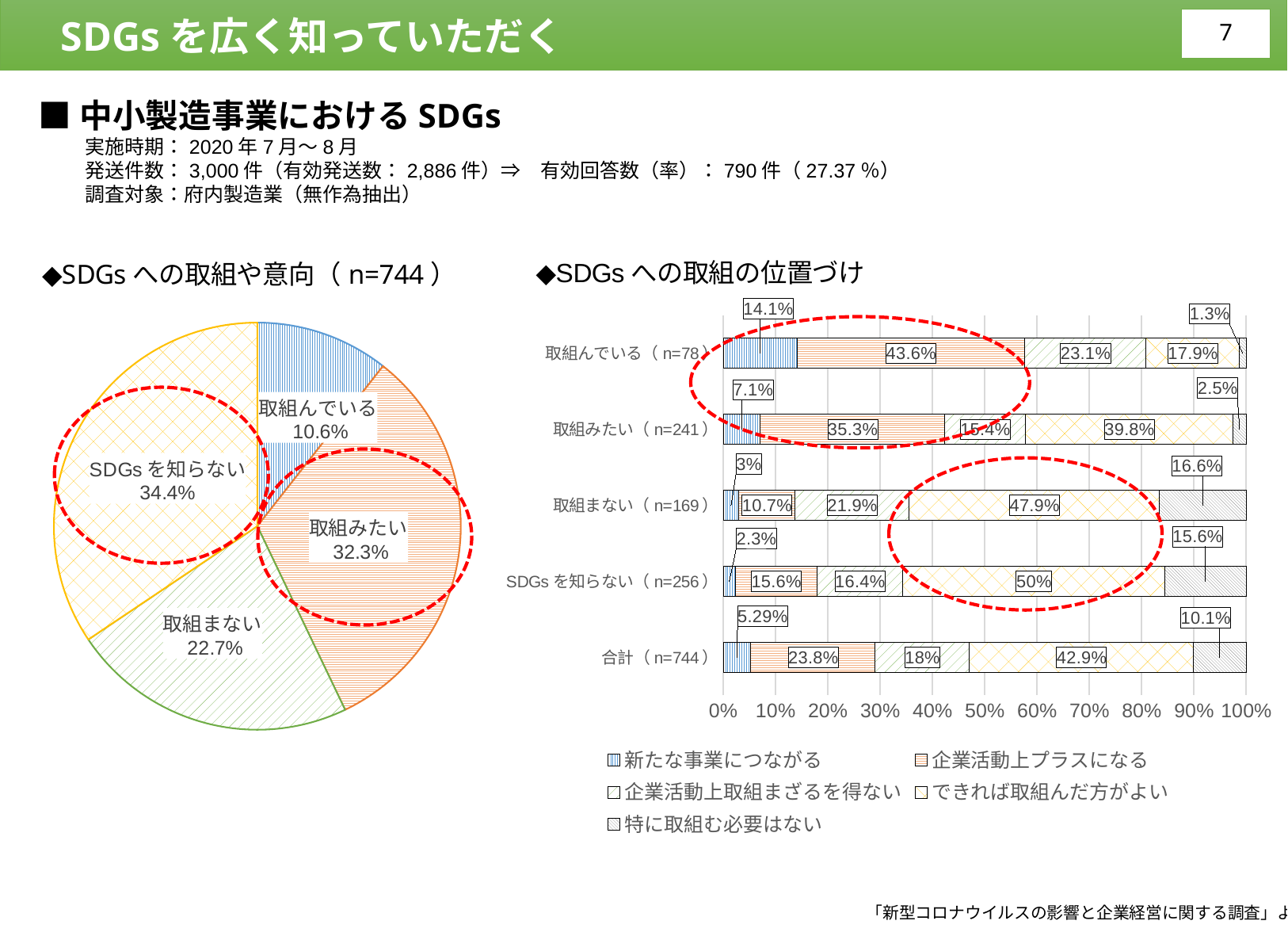
In the pie chart 'SDGsへの取組や意向（n=744）', which category has the smallest share? 取組んでいる In the bar chart 'SDGsへの取組の位置づけ', which is larger for 取組まない（n=169）: 企業活動上取組まざるを得ない or 特に取組む必要はない? 企業活動上取組まざるを得ない In the pie chart 'SDGsへの取組や意向（n=744）', which category has the largest share? SDGsを知らない In the bar chart 'SDGsへの取組の位置づけ', what is the difference between 新たな事業につながる for 取組んでいる（n=78） and for 取組みたい（n=241）? 7% In the bar chart 'SDGsへの取組の位置づけ', what is the value of 新たな事業につながる for 合計（n=744）? 5.29% In the bar chart 'SDGsへの取組の位置づけ', how many series does the legend list? 5 In the pie chart 'SDGsへの取組や意向（n=744）', how many slices are there? 4 In the bar chart 'SDGsへの取組の位置づけ', what is the value of 企業活動上プラスになる for 取組んでいる（n=78）? 43.6% What type of chart is 'SDGsへの取組の位置づけ'? Stacked bar chart In the bar chart 'SDGsへの取組の位置づけ', what is the value of できれば取組んだ方がよい for SDGsを知らない（n=256）? 50% In the pie chart 'SDGsへの取組や意向（n=744）', what percentage is shown for 取組みたい? 32.3% In the pie chart 'SDGsへの取組や意向（n=744）', what is the difference between the shares of SDGsを知らない and 取組まない? 11.7%